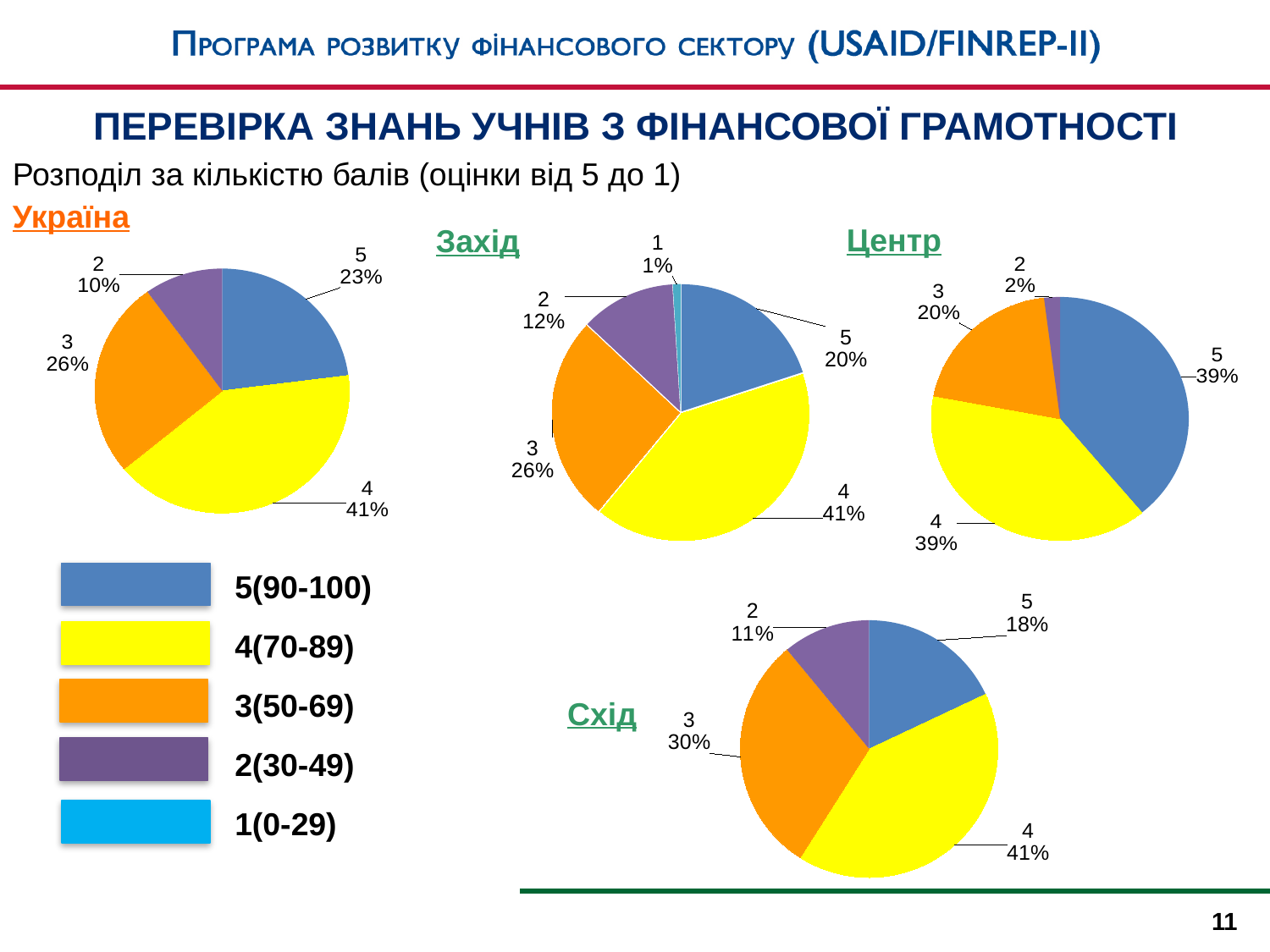
What type of chart is used for the Україна data? Pie chart In the Центр pie chart, what share of students scored 3 (50-69)? 20% How many slices does the Захід pie chart have? 5 In the Захід pie chart, what is the difference between the share for score 4 and the share for score 3? 15% In the Схід pie chart, what is the combined share of students who scored 5 or 4? 59% In the Схід pie chart, which score category has the largest share? 4 In the Україна pie chart, which score category has the smallest share? 2 In the Захід pie chart, what share of students scored 1 (0-29)? 1% In the Схід pie chart, what share of students scored 5 (90-100)? 18% In the Україна pie chart, what share of students scored 4 (70-89)? 41% In the Центр pie chart, which is larger: the share for score 3 or the share for score 2? 3 How many categories does the legend on the slide list? 5